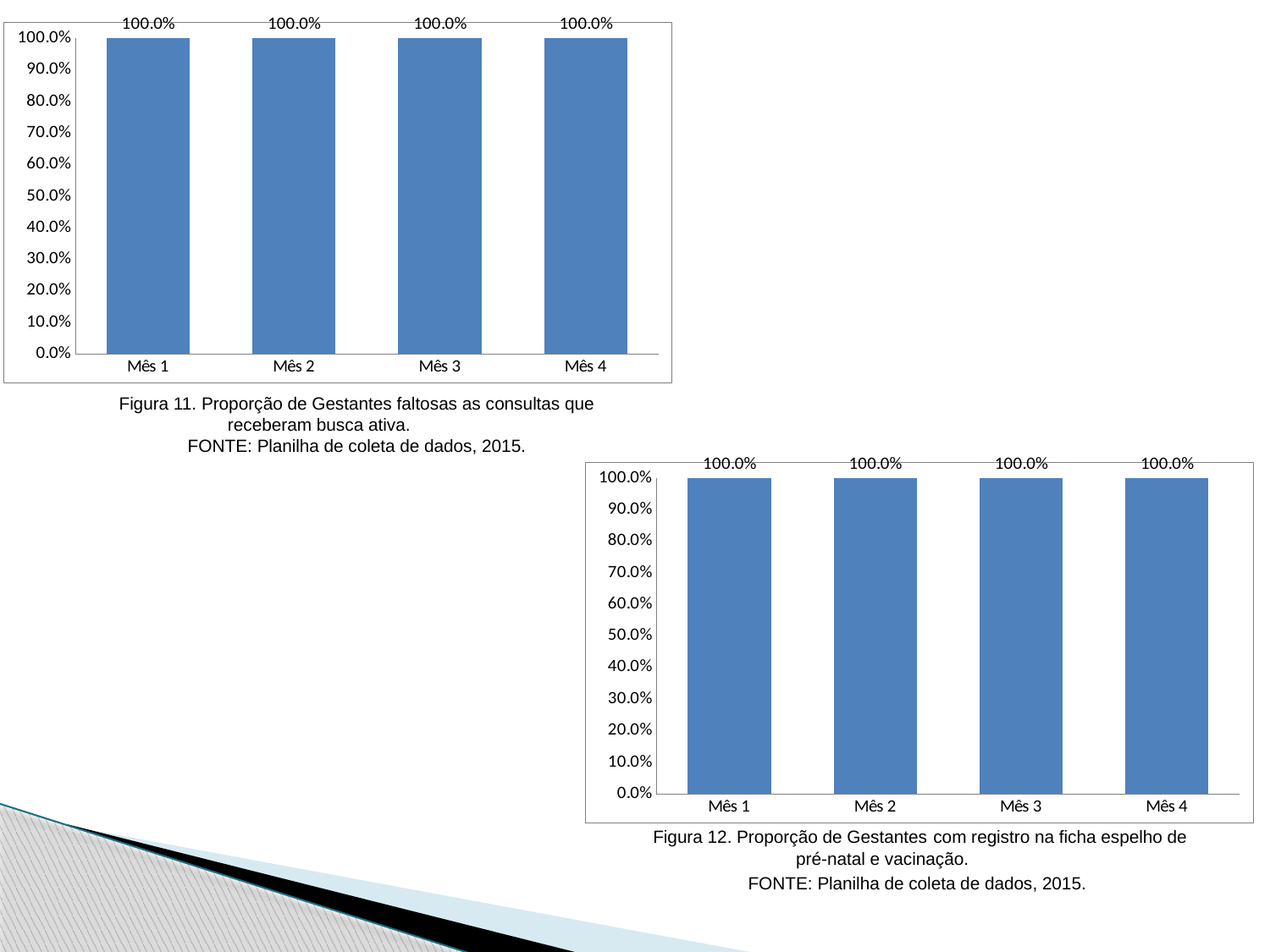
How many bars are plotted in the bottom-right chart (Figura 12)? 4 What kind of chart is the top-left chart (Figura 11)? bar chart What is the caption title of the bottom-right chart? Figura 12. Proporção de Gestantes com registro na ficha espelho de pré-natal e vacinação. In the bottom-right chart (Figura 12), what is the difference between the values for Mês 1 and Mês 4? 0.0% How many categories are shown on the x axis of the top-left chart (Figura 11)? 4 In the bottom-right chart (Figura 12), what is the value for Mês 2? 100.0% In the top-left chart (Figura 11), do the values rise, fall or stay the same from Mês 1 to Mês 4? stay the same In the bottom-right chart (Figura 12), what is the value for Mês 3? 100.0% In the top-left chart (Figura 11), what is the value for Mês 4? 100.0% What kind of chart is the bottom-right chart (Figura 12)? bar chart In the top-left chart (Figura 11), is the value for Mês 2 greater or less than 50.0%? greater In the top-left chart (Figura 11), what is the value for Mês 1? 100.0%